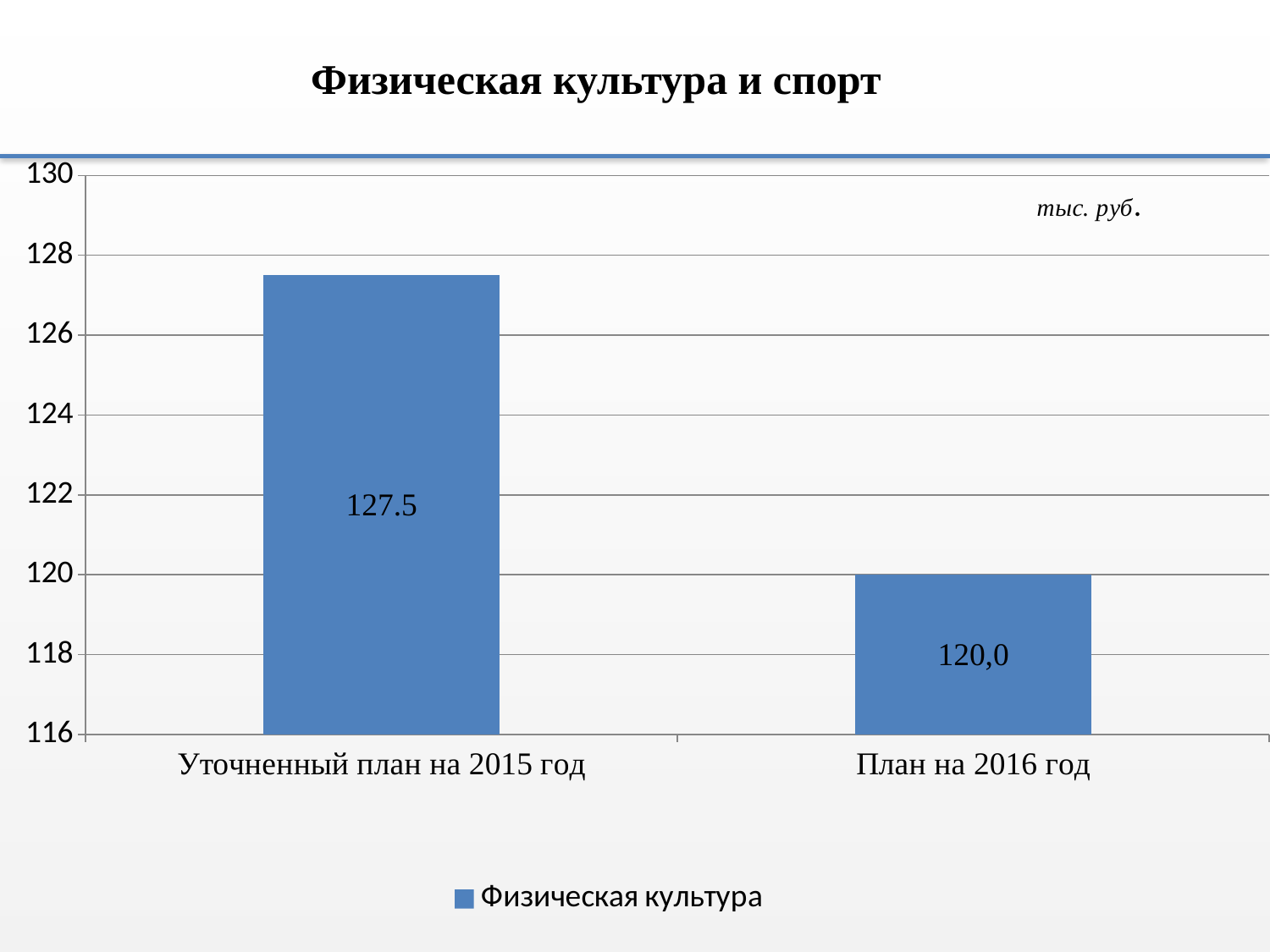
Do the values rise or fall from "Уточненный план на 2015 год" to "План на 2016 год"? fall What is the value for "Уточненный план на 2015 год"? 127.5 Which category has the lowest value? План на 2016 год What is the title of the chart? Физическая культура и спорт What kind of chart is shown on the slide? bar chart What is the difference between the value for "Уточненный план на 2015 год" and the value for "План на 2016 год"? 7.5 Which category has the highest value? Уточненный план на 2015 год How many categories are shown on the x axis? 2 How many series does the legend list? 1 What is the value for "План на 2016 год"? 120,0 Which is larger: the value for "Уточненный план на 2015 год" or the value for "План на 2016 год"? Уточненный план на 2015 год Is the value for "Уточненный план на 2015 год" greater or less than 126? greater